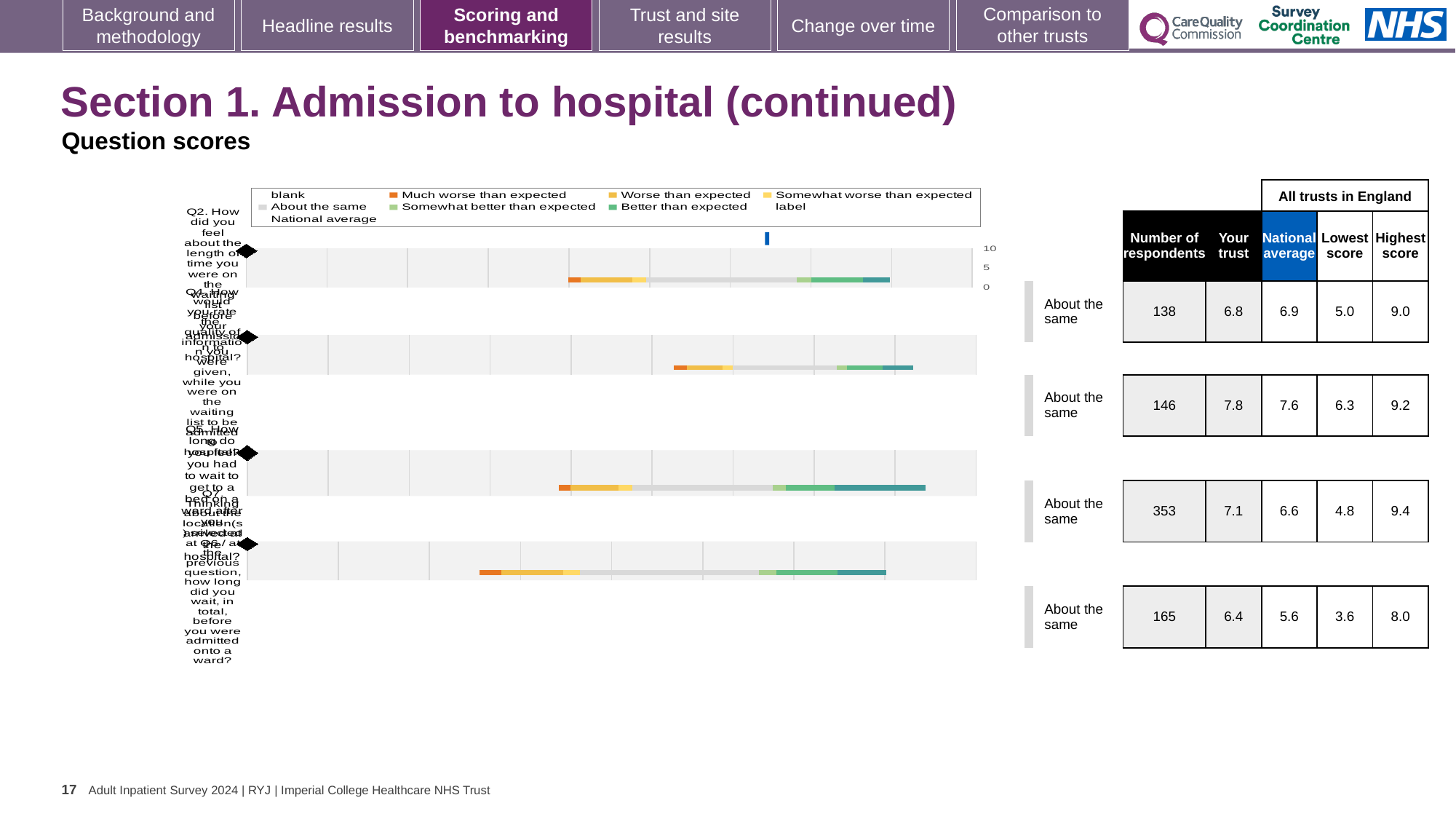
What is the highest value shown on the chart's axis? 10 In the table beside the chart, what is the 'Your trust' score for the second question row? 7.8 In the table beside the chart, what is the lowest score for the fourth question row? 3.6 What is the highest score listed for the third question row in the table? 9.4 What benchmark label is shown next to each of the four question rows? About the same How many question bars are plotted in the chart? 4 For the fourth question row, what is the difference between the 'Your trust' score and the national average? 0.8 In the table beside the chart, what is the number of respondents for the first question row? 138 What kind of chart is shown on the slide? bar chart Which question row has the highest number of respondents in the table? the third row (353) In the table beside the chart, what is the national average for the third question row? 6.6 For the first question row, which is larger: the 'Your trust' score or the national average? National average